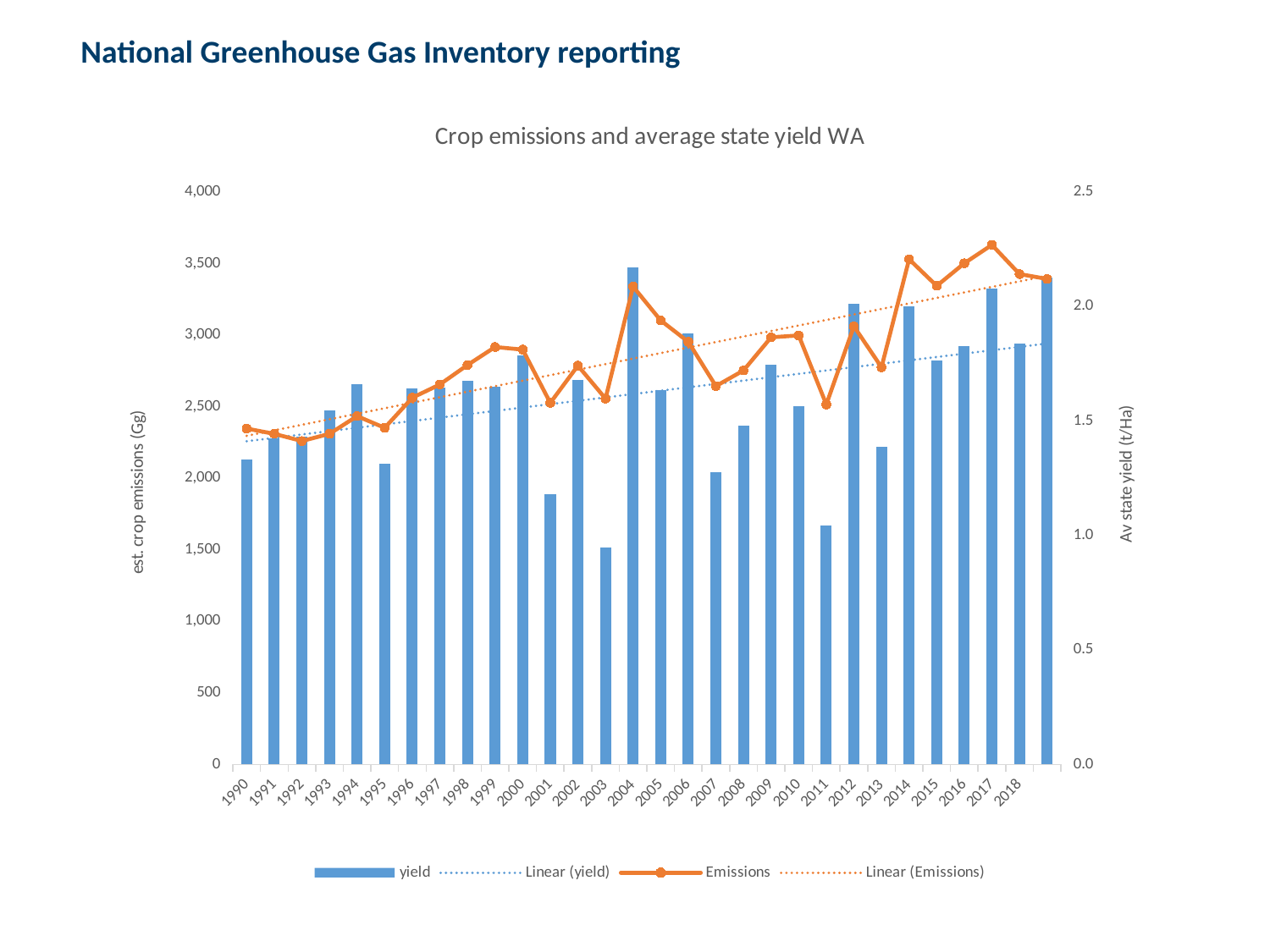
In which year does the Emissions line reach its highest point? 2017 Which year has the shortest yield bar? 2003 Which year has the taller yield bar, 2011 or 2012? 2012 How many years are shown along the x axis of the chart? 29 Which year has the tallest yield bar? 2004 What kind of chart is shown on the slide? Combined bar and line chart How many entries does the chart legend list? 4 What is the title of the chart on the slide? Crop emissions and average state yield WA Does the Emissions line generally rise or fall from 1990 to 2018? rise